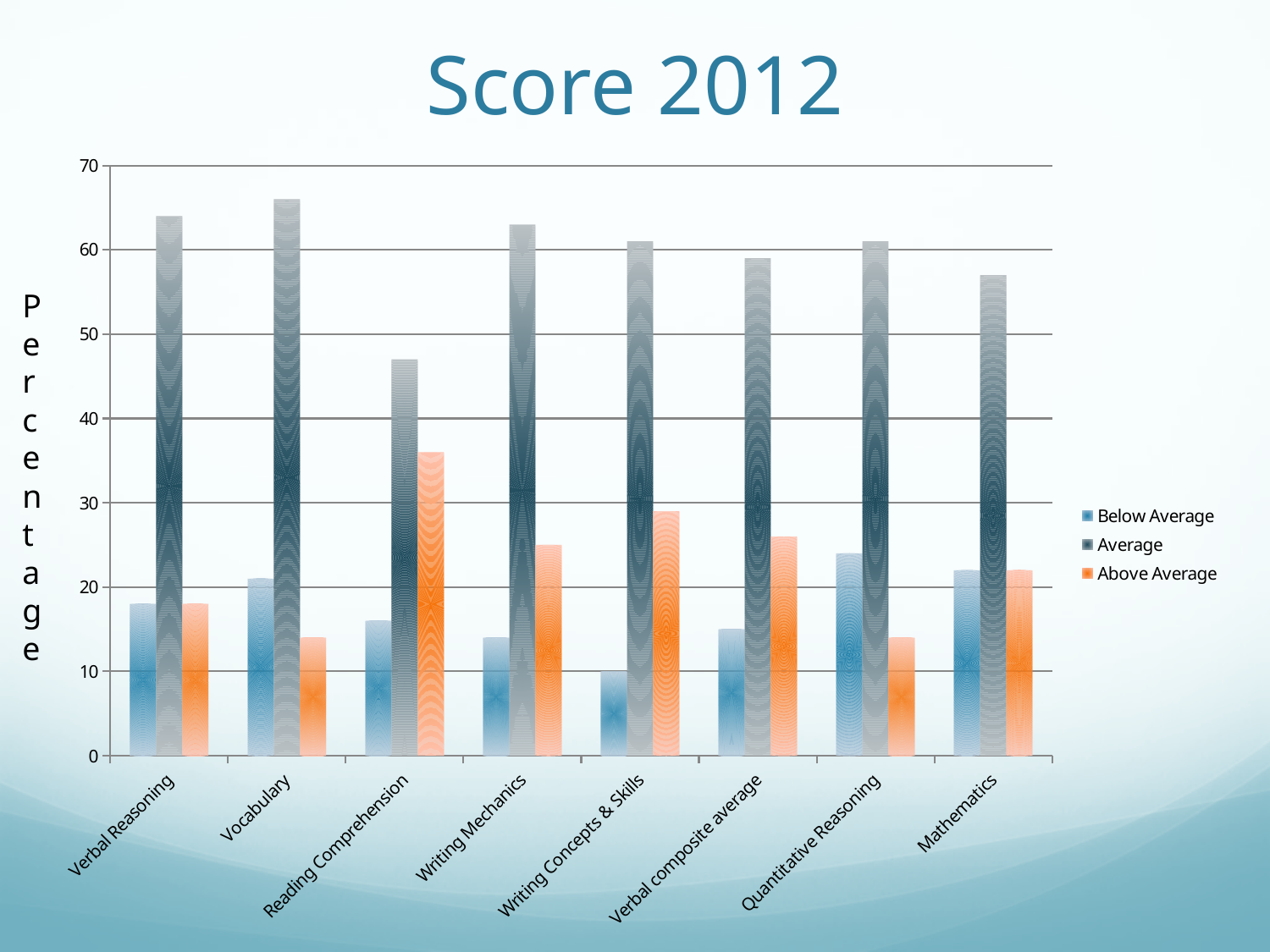
How many categories are shown on the x axis? 8 Which category has the lowest Below Average value? Writing Concepts & Skills What is the label on the vertical axis? Percentage Is the Above Average value for Reading Comprehension greater or less than 30? greater Which category has the highest Above Average value? Reading Comprehension How many series does the legend list? 3 Which category has the lowest Average value? Reading Comprehension For Vocabulary, which is larger: the Below Average value or the Above Average value? Below Average What kind of chart is shown on the slide? bar chart Is the Below Average value for Quantitative Reasoning greater or less than 20? greater Is the Average value for Reading Comprehension greater or less than 50? less